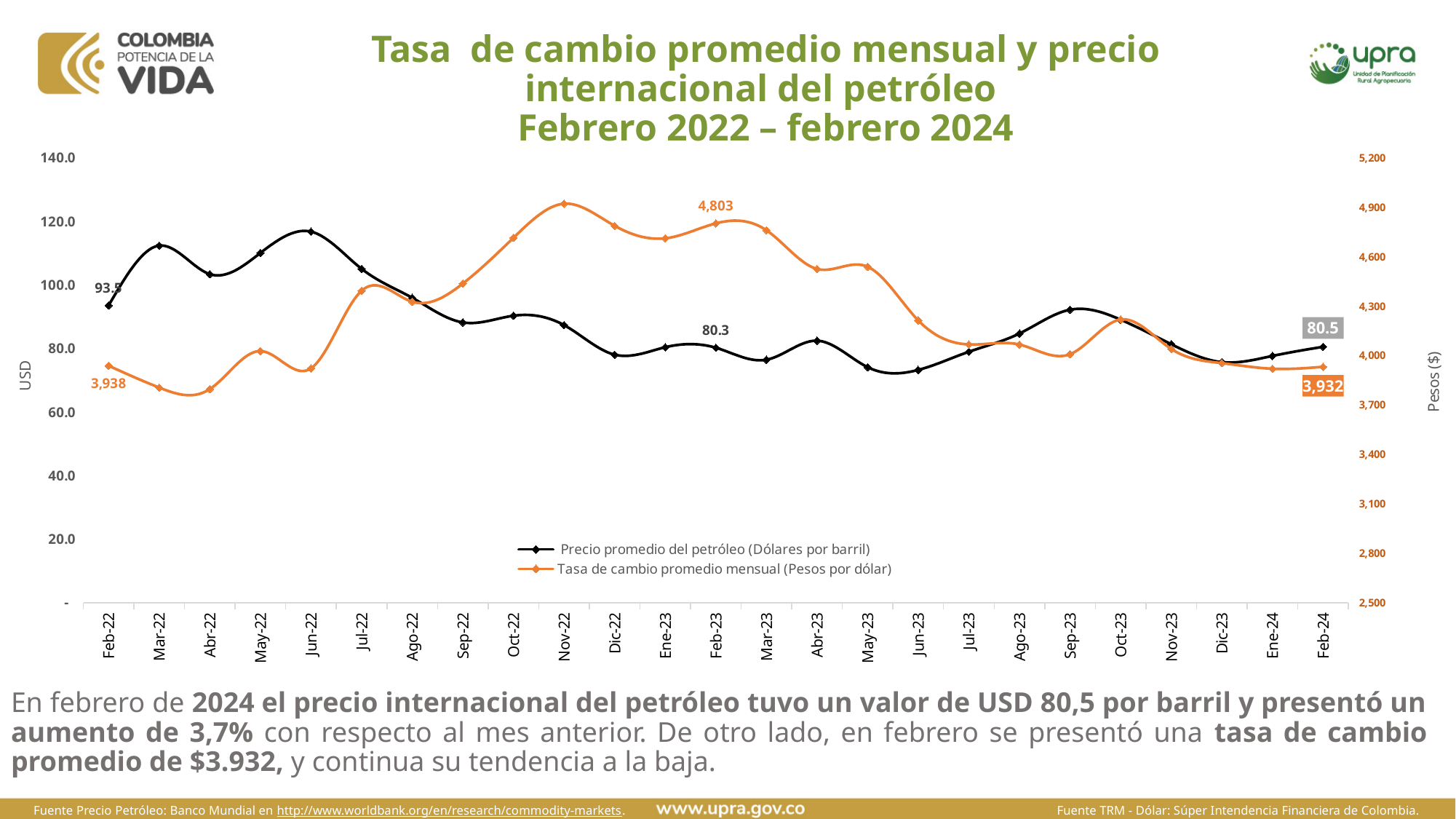
What is the value of Precio promedio del petróleo (Dólares por barril) for Feb-22? 93.5 What is the difference between the Tasa de cambio promedio mensual values for Feb-23 and Feb-24? 871 What kind of chart is shown on the slide? Line chart How many months are plotted along the x axis? 25 How many series does the legend list? 2 What is the value of Tasa de cambio promedio mensual (Pesos por dólar) for Feb-24? 3,932 Is the value of Tasa de cambio promedio mensual (Pesos por dólar) for Nov-22 greater or less than 4,600? greater In which month does Tasa de cambio promedio mensual (Pesos por dólar) reach its highest value? Nov-22 Which is larger, the Precio promedio del petróleo for Feb-22 or for Feb-24? Feb-22 What is the value of Precio promedio del petróleo (Dólares por barril) for Feb-24? 80.5 What is the value of Tasa de cambio promedio mensual (Pesos por dólar) for Feb-23? 4,803 Is the value of Precio promedio del petróleo (Dólares por barril) for Jun-22 greater or less than 100.0? greater